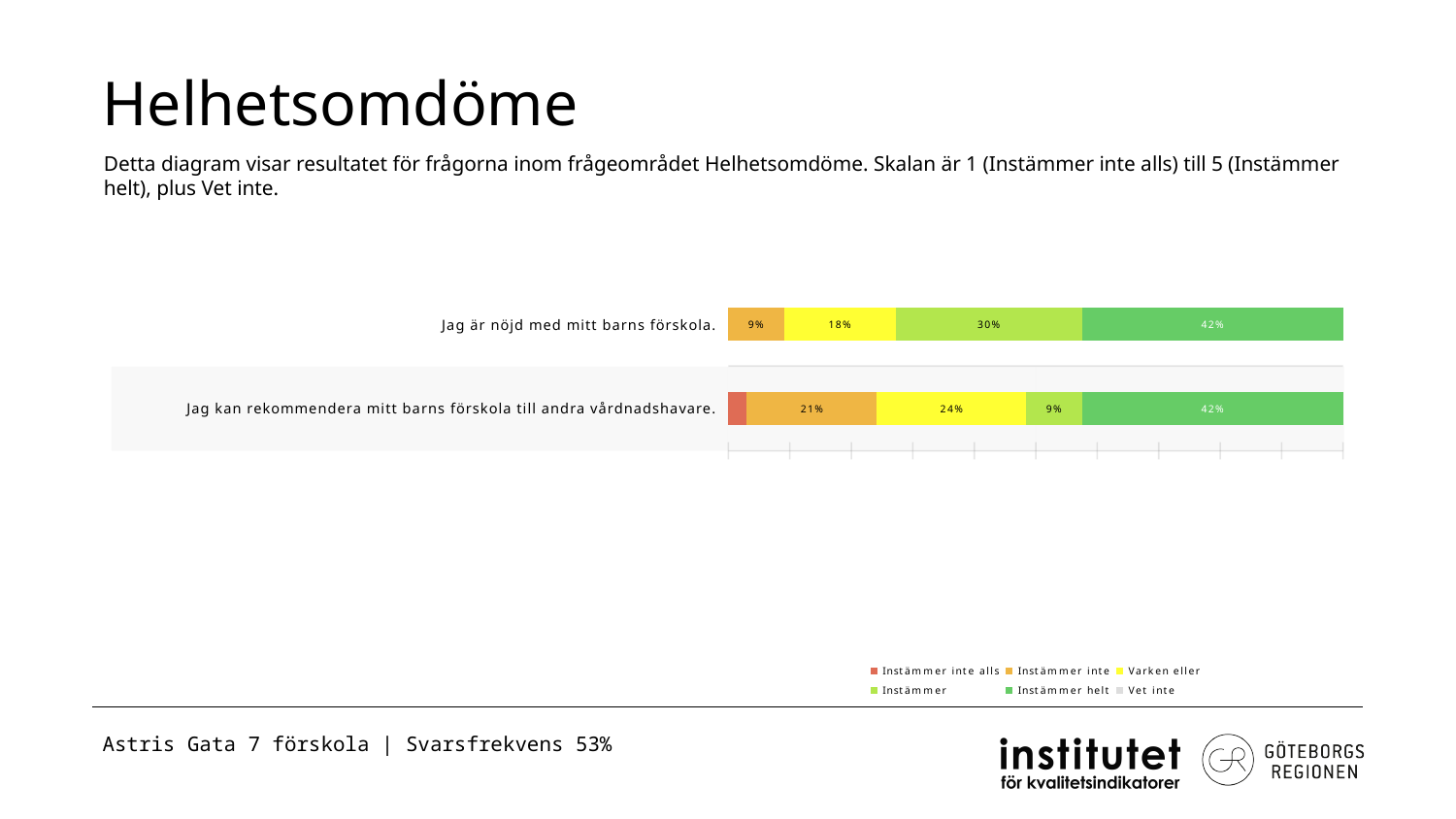
What kind of chart is shown on the slide? Stacked bar chart What is the difference between the "Instämmer" values of the two questions (30% and 9%)? 21 percentage points What is the value of "Instämmer inte" for "Jag kan rekommendera mitt barns förskola till andra vårdnadshavare."? 21% What is the value of "Instämmer" for "Jag kan rekommendera mitt barns förskola till andra vårdnadshavare."? 9% What is the difference between the "Instämmer inte" values of the two questions (21% and 9%)? 12 percentage points Which legend entry is shown in red? Instämmer inte alls How many questions (categories) are plotted in the chart? 2 What is the value of "Instämmer" for "Jag är nöjd med mitt barns förskola."? 30% What is the value of "Varken eller" for "Jag kan rekommendera mitt barns förskola till andra vårdnadshavare."? 24% How many series does the legend list? 6 Which question has the larger "Instämmer" share: "Jag är nöjd med mitt barns förskola." or "Jag kan rekommendera mitt barns förskola till andra vårdnadshavare."? Jag är nöjd med mitt barns förskola. What is the value of "Instämmer helt" for "Jag är nöjd med mitt barns förskola."? 42%